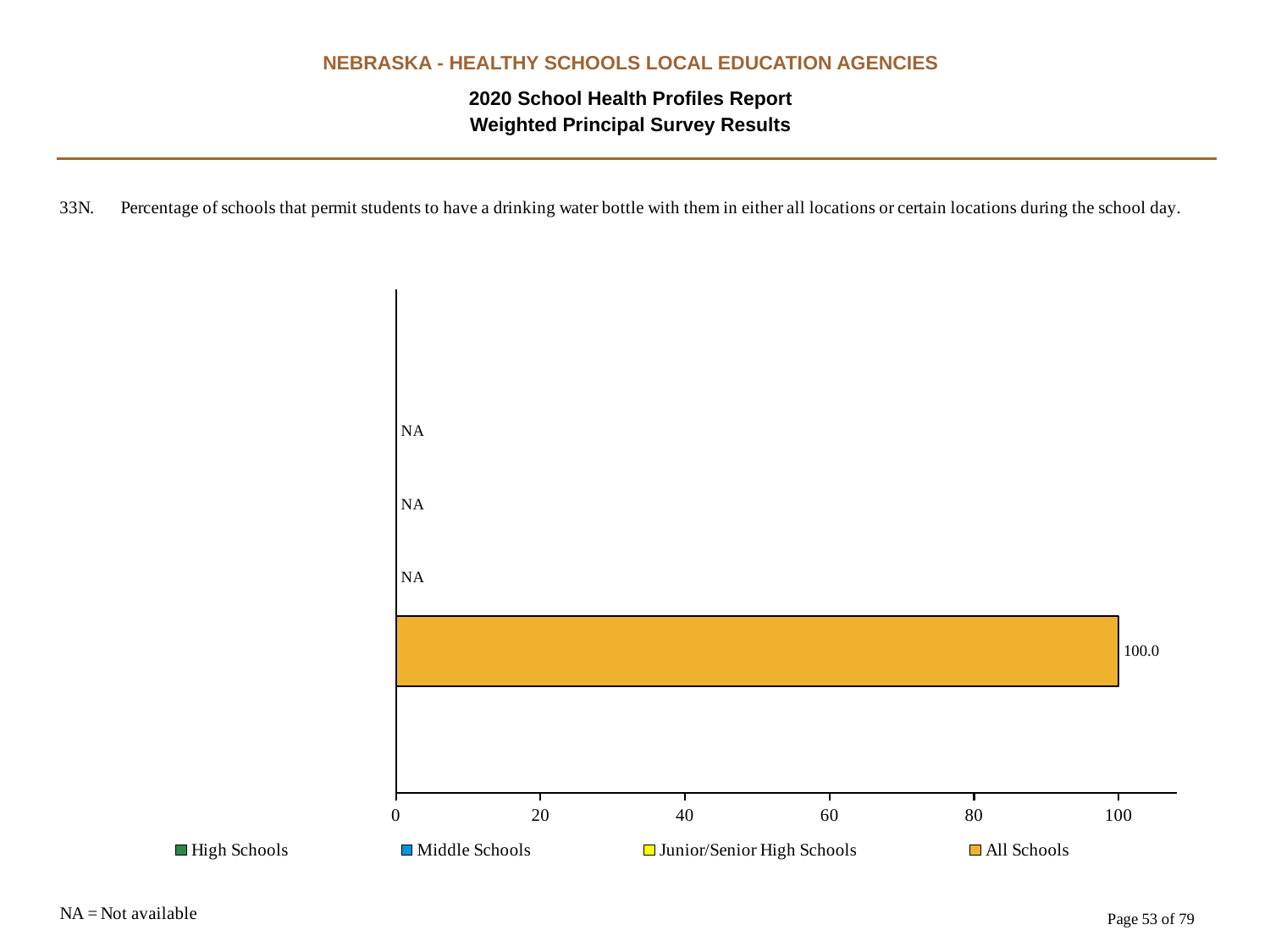
How many series does the legend list? 4 What is the value for All Schools? 100.0 What is shown for Junior/Senior High Schools instead of a value? NA Which series has a plotted bar with a numeric value? All Schools What does NA stand for according to the note on the slide? Not available What is shown for High Schools instead of a value? NA What kind of chart is shown on the slide? bar chart Is the value for All Schools greater or less than 80? greater What is the highest tick value shown on the x axis? 100 How many series are marked NA on the chart? 3 What is shown for Middle Schools instead of a value? NA